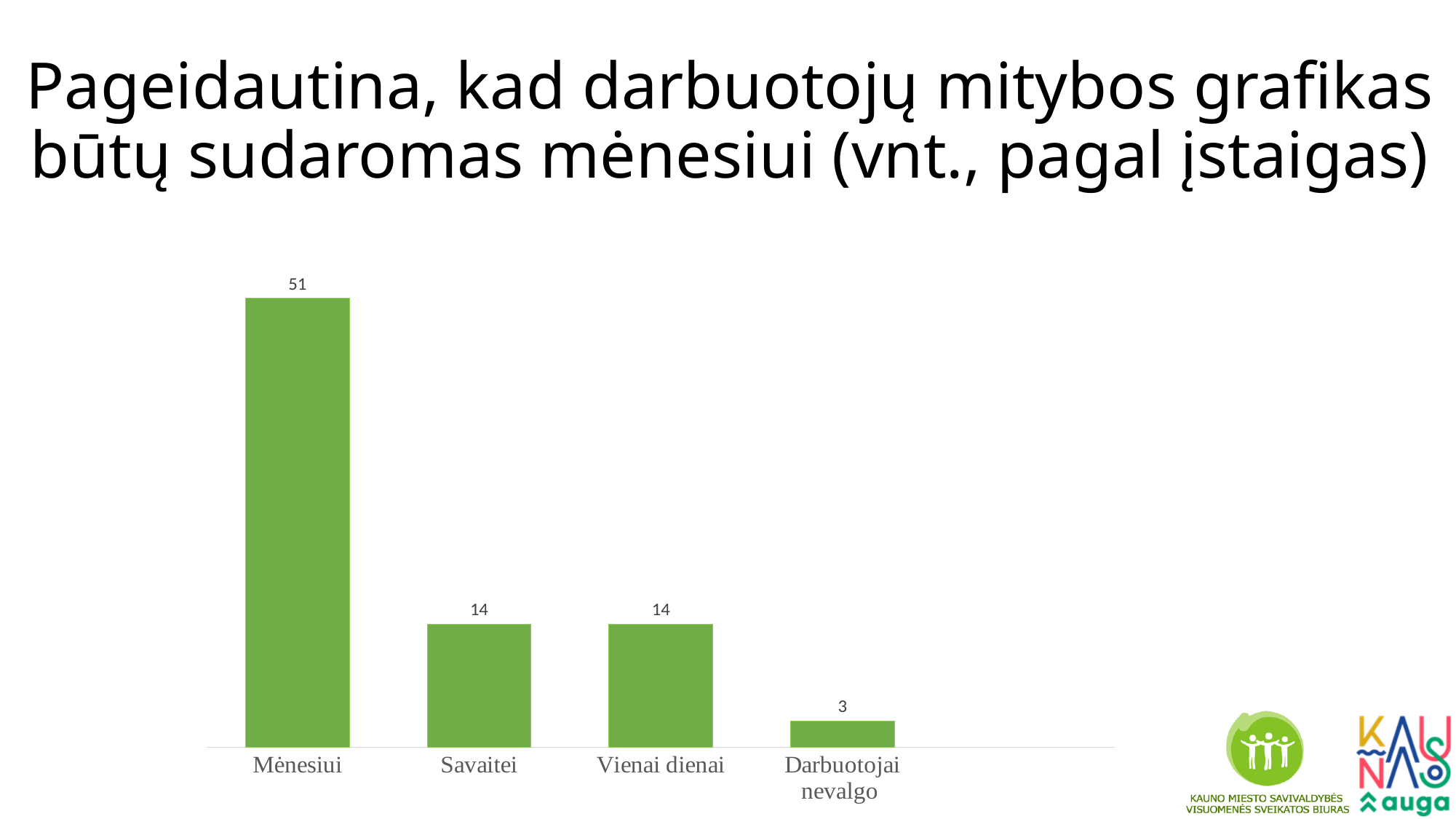
What colour are the bars in the chart? Green What is the value for Darbuotojai nevalgo? 3 What is the difference between the values for Vienai dienai and Darbuotojai nevalgo? 11 Which category has the highest value? Mėnesiui What is the value for Vienai dienai? 14 Which is larger, the value for Mėnesiui or the value for Vienai dienai? Mėnesiui Which category has the lowest value? Darbuotojai nevalgo How many categories are shown in the chart? 4 What is the value for Savaitei? 14 What kind of chart is shown on the slide? Bar chart What is the difference between the values for Mėnesiui and Savaitei? 37 What is the value for Mėnesiui? 51